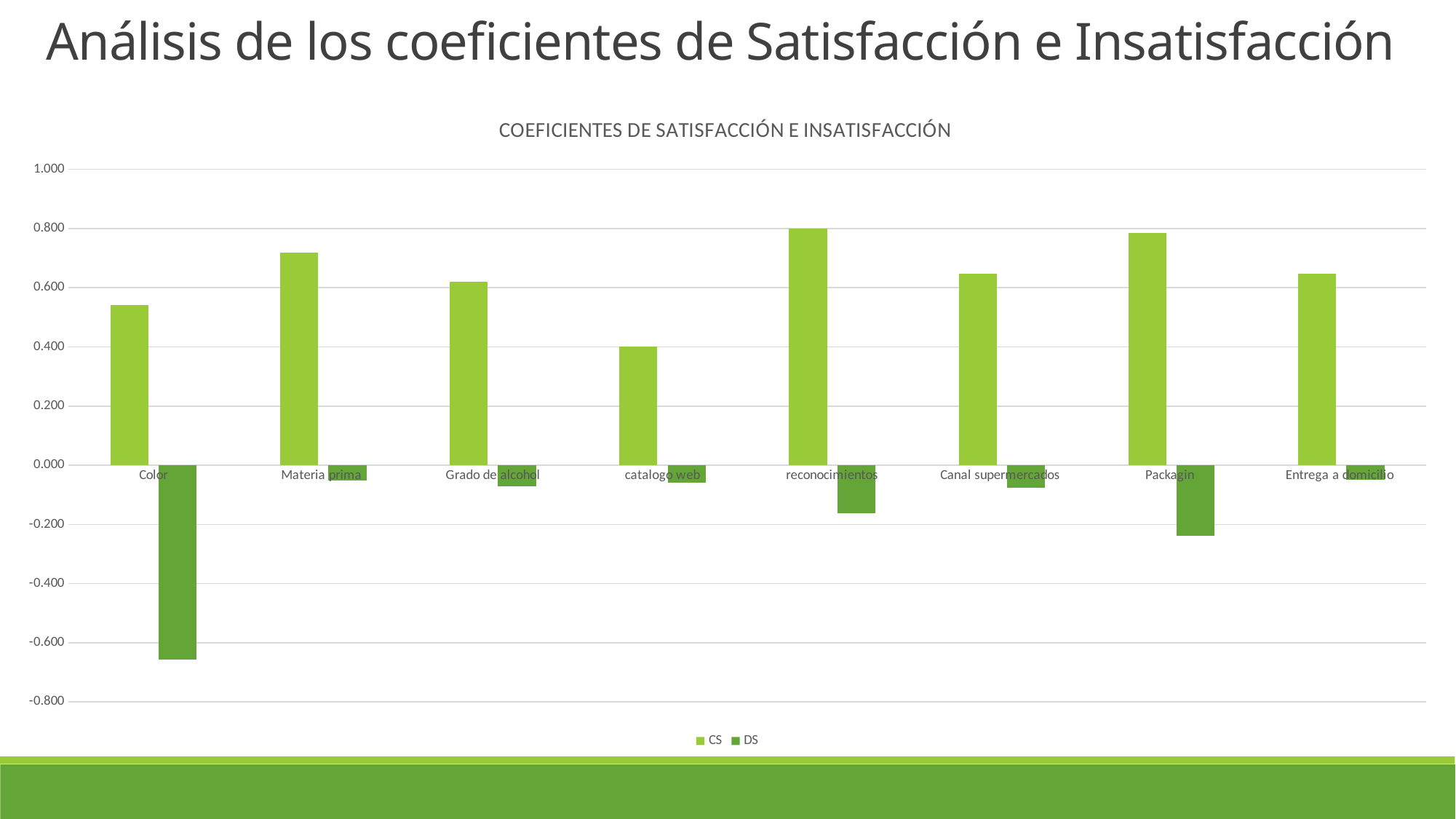
What kind of chart is shown on the slide? bar chart Which is lower, the DS value for Color or the DS value for Packagin? Color Is the CS value for Materia prima greater or less than 0.600? greater Which is larger, the CS value for Materia prima or the CS value for Grado de alcohol? Materia prima Which category has the lowest (most negative) DS value? Color How many series does the legend list? 2 Which category has the lowest CS value? catalogo web What are the two series named in the legend? CS and DS Is the CS value for Color greater or less than 0.400? greater What is the title of the chart? COEFICIENTES DE SATISFACCIÓN E INSATISFACCIÓN How many categories are shown on the x axis of the chart? 8 Is the DS value for Color greater or less than -0.600? less